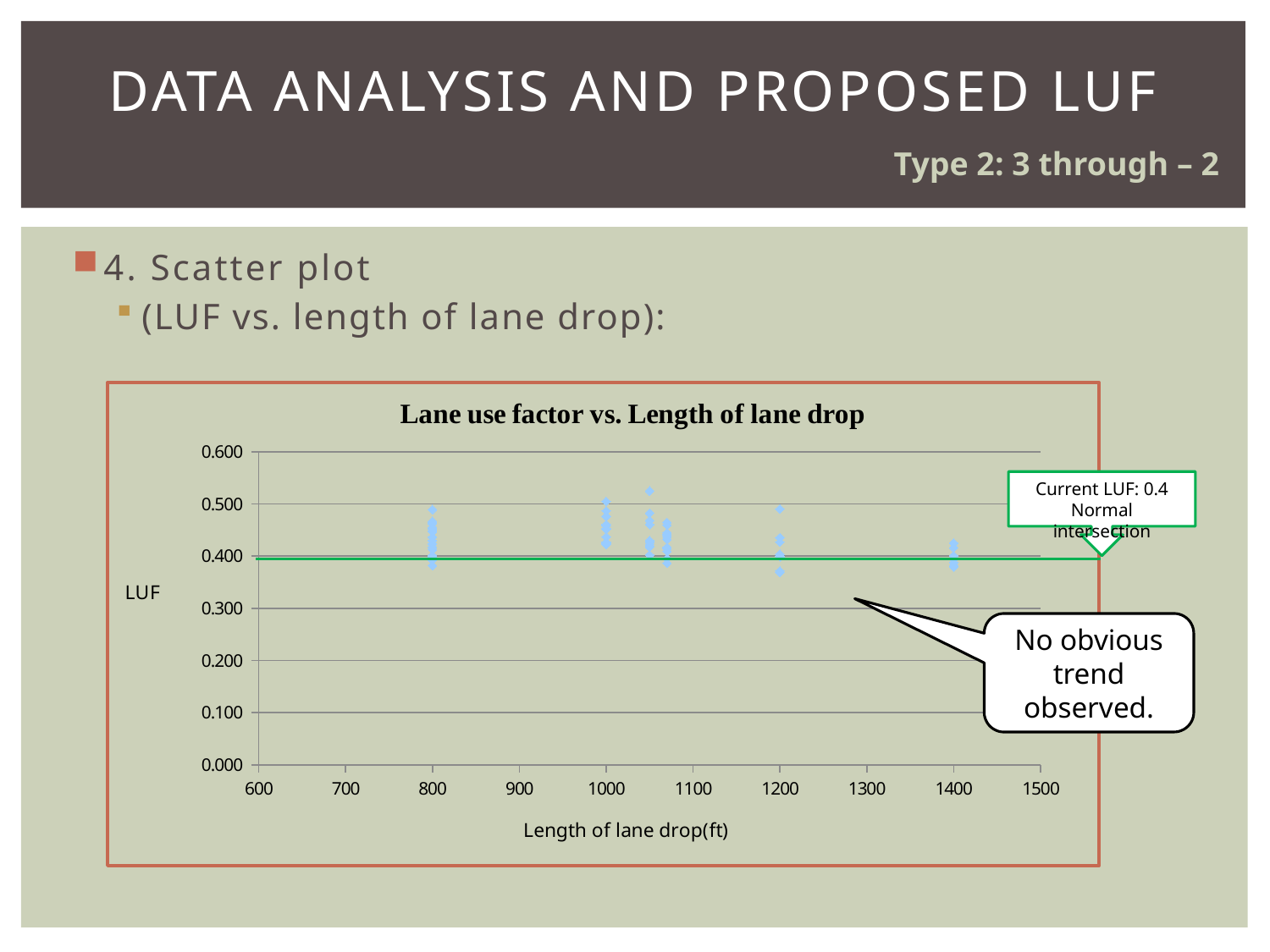
Are the plotted points at a lane drop length of 800 ft greater or less than 0.300 LUF? greater Are the plotted points at 1400 ft greater or less than 0.500 LUF? less How many tick labels are shown along the x axis of the chart? 10 What value does the green horizontal line on the chart mark as the current LUF? 0.4 What is the title of the chart? Lane use factor vs. Length of lane drop What is the label of the x axis of the chart? Length of lane drop(ft) What is the lowest tick value shown on the x axis of the chart? 600 Is the highest plotted point at 1050 ft greater or less than 0.400 LUF? greater What is the highest tick value shown on the y axis of the chart? 0.600 What kind of chart is shown on the slide? Scatter plot According to the callout on the chart, is there a clear trend in LUF as the length of lane drop increases? No obvious trend observed